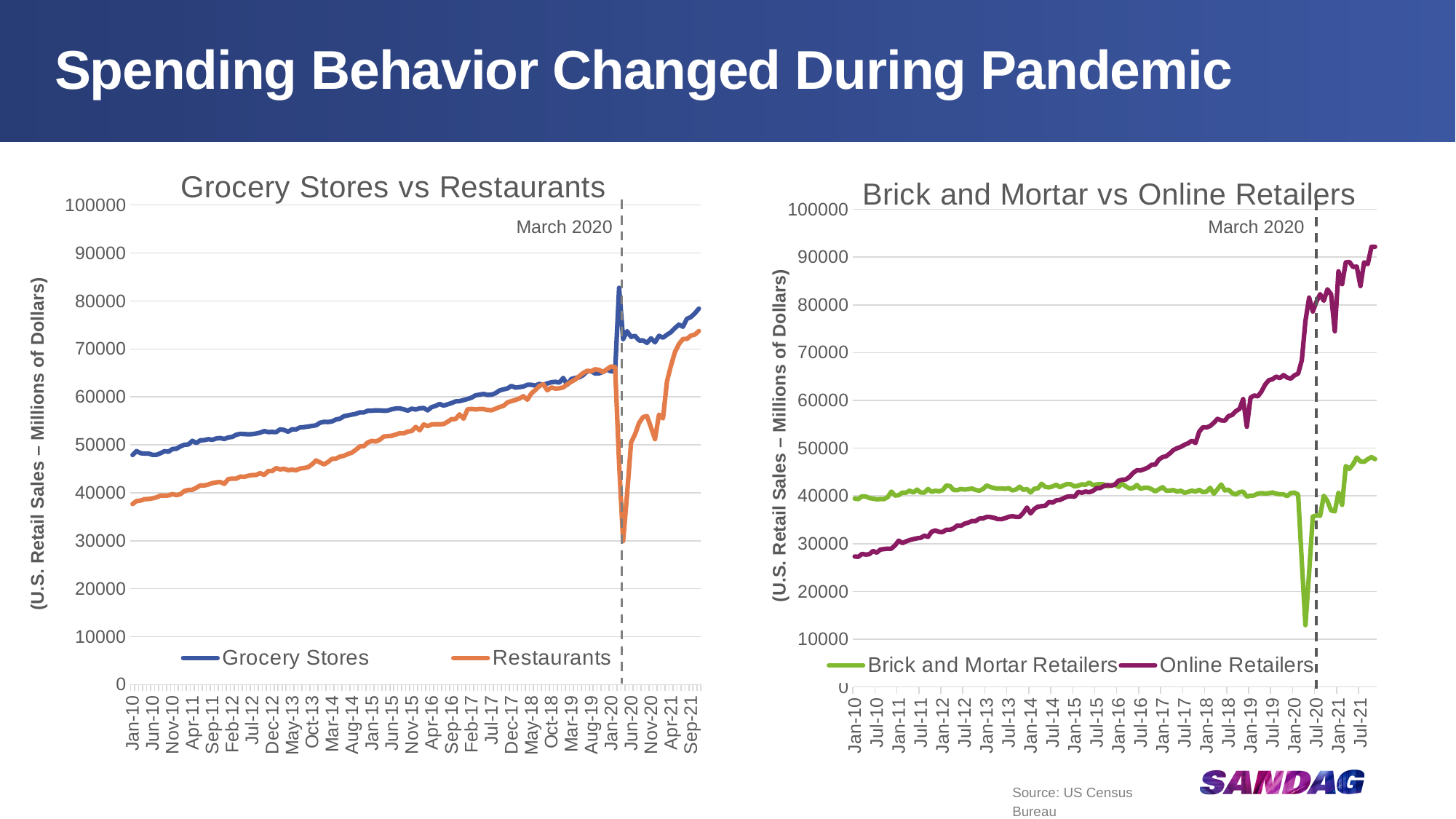
What date does the dashed vertical line in each chart mark? March 2020 In the 'Brick and Mortar vs Online Retailers' chart, is the Online Retailers value at Jan-10 greater or less than 30000? less How many series does the legend of the 'Brick and Mortar vs Online Retailers' chart list? 2 In the 'Grocery Stores vs Restaurants' chart, is the Restaurants value at Jan-10 greater or less than 40000? less In the 'Grocery Stores vs Restaurants' chart, which series is higher at Jan-10, Grocery Stores or Restaurants? Grocery Stores In the 'Brick and Mortar vs Online Retailers' chart, is the lowest point of the Brick and Mortar Retailers line in 2020 greater or less than 20000? less In the 'Brick and Mortar vs Online Retailers' chart, which series is higher at the end of the period (Jul-21), Brick and Mortar Retailers or Online Retailers? Online Retailers What kind of chart is the 'Grocery Stores vs Restaurants' chart? line chart In the 'Brick and Mortar vs Online Retailers' chart, does the Online Retailers line rise or fall over the whole period? rise In the 'Grocery Stores vs Restaurants' chart, does the Restaurants line generally rise or fall from Jan-10 to Jan-20? rise In the 'Brick and Mortar vs Online Retailers' chart, which series is higher at Jan-10, Brick and Mortar Retailers or Online Retailers? Brick and Mortar Retailers